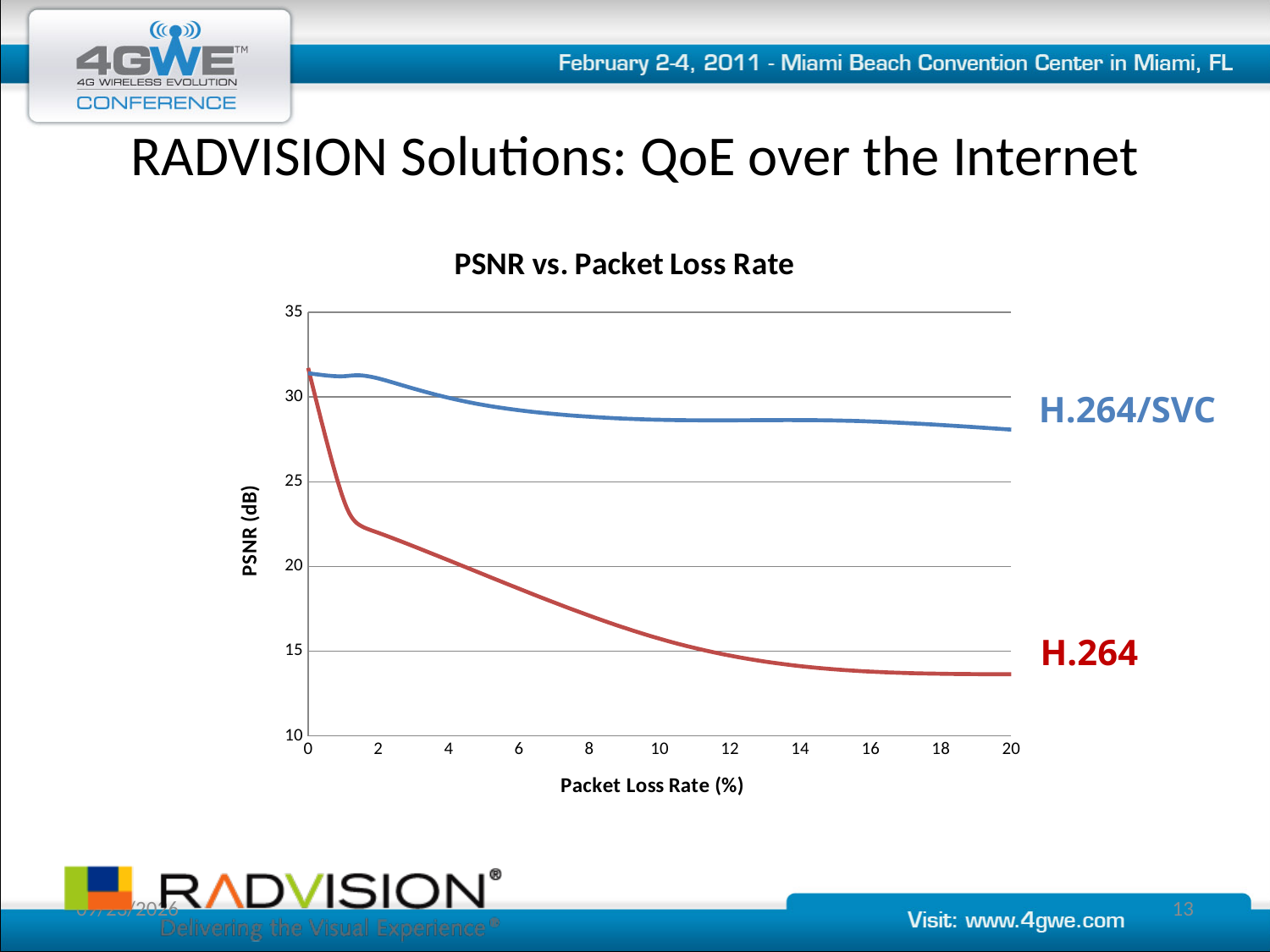
What is the title of the chart? PSNR vs. Packet Loss Rate Is the PSNR for H.264 at a packet loss rate of 20% greater or less than 15? less What kind of chart is shown on the slide? line chart Is the PSNR for H.264/SVC at a packet loss rate of 0% greater or less than 30? greater Is the PSNR for H.264 at a packet loss rate of 2% greater or less than 20? greater Does the PSNR for H.264 rise or fall as the packet loss rate increases? fall At a packet loss rate of 10%, which series has the higher PSNR, H.264/SVC or H.264? H.264/SVC Does the PSNR for H.264/SVC rise or fall as the packet loss rate increases from 0 to 20? fall How many series are plotted in the chart? 2 What is the label of the y axis? PSNR (dB)